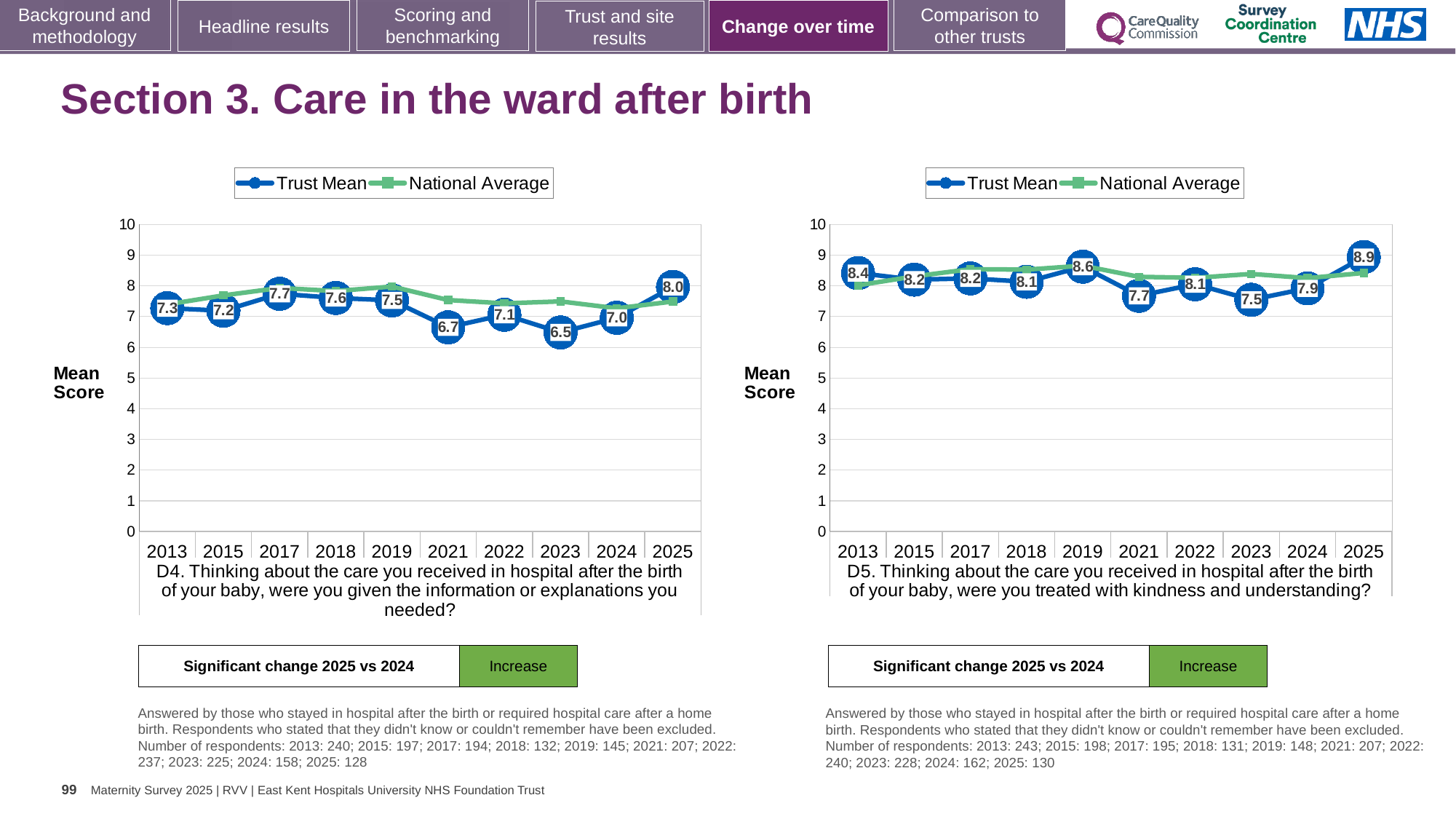
What type of chart is the left chart (D4)? Line chart In the right chart (D5), is the National Average for 2025 greater or less than 8? greater In the right chart (D5), what is the Trust Mean score for 2021? 7.7 In the left chart (D4), what is the Trust Mean score for 2025? 8.0 In the left chart (D4), what is the difference between the Trust Mean scores for 2025 and 2024? 1.0 In the right chart (D5), what does the 'Significant change 2025 vs 2024' box say? Increase In the right chart (D5), which year has the highest Trust Mean score? 2025 How many series does the legend of the right chart (D5) list? 2 In the left chart (D4), is the Trust Mean score higher in 2017 or in 2021? 2017 In the right chart (D5), what is the difference between the Trust Mean scores for 2019 and 2023? 1.1 In the left chart (D4), which year has the lowest Trust Mean score? 2023 How many years are plotted on the x axis of the left chart (D4)? 10